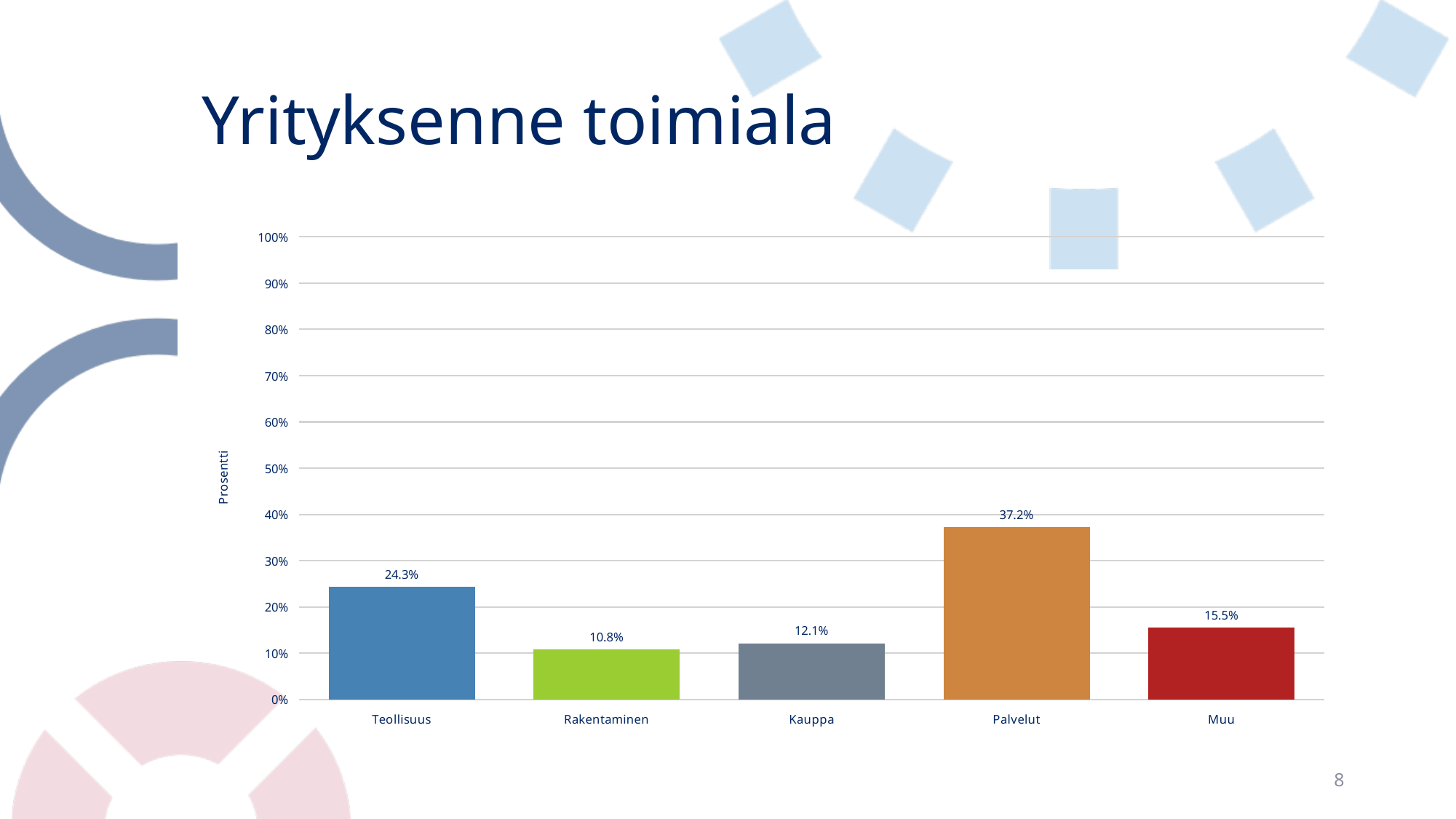
How many categories are shown on the x axis? 5 What kind of chart is shown on the slide? bar chart Which category has the highest value? Palvelut What is the value for Palvelut? 37.2% What is the value for Muu? 15.5% What is the difference between the values for Kauppa and Rakentaminen? 1.3% What is the label of the y axis? Prosentti What is the value for Teollisuus? 24.3% Which is larger, the value for Muu or the value for Kauppa? Muu What is the difference between the values for Palvelut and Teollisuus? 12.9% Is the value for Teollisuus greater or less than 20%? greater Which category has the lowest value? Rakentaminen